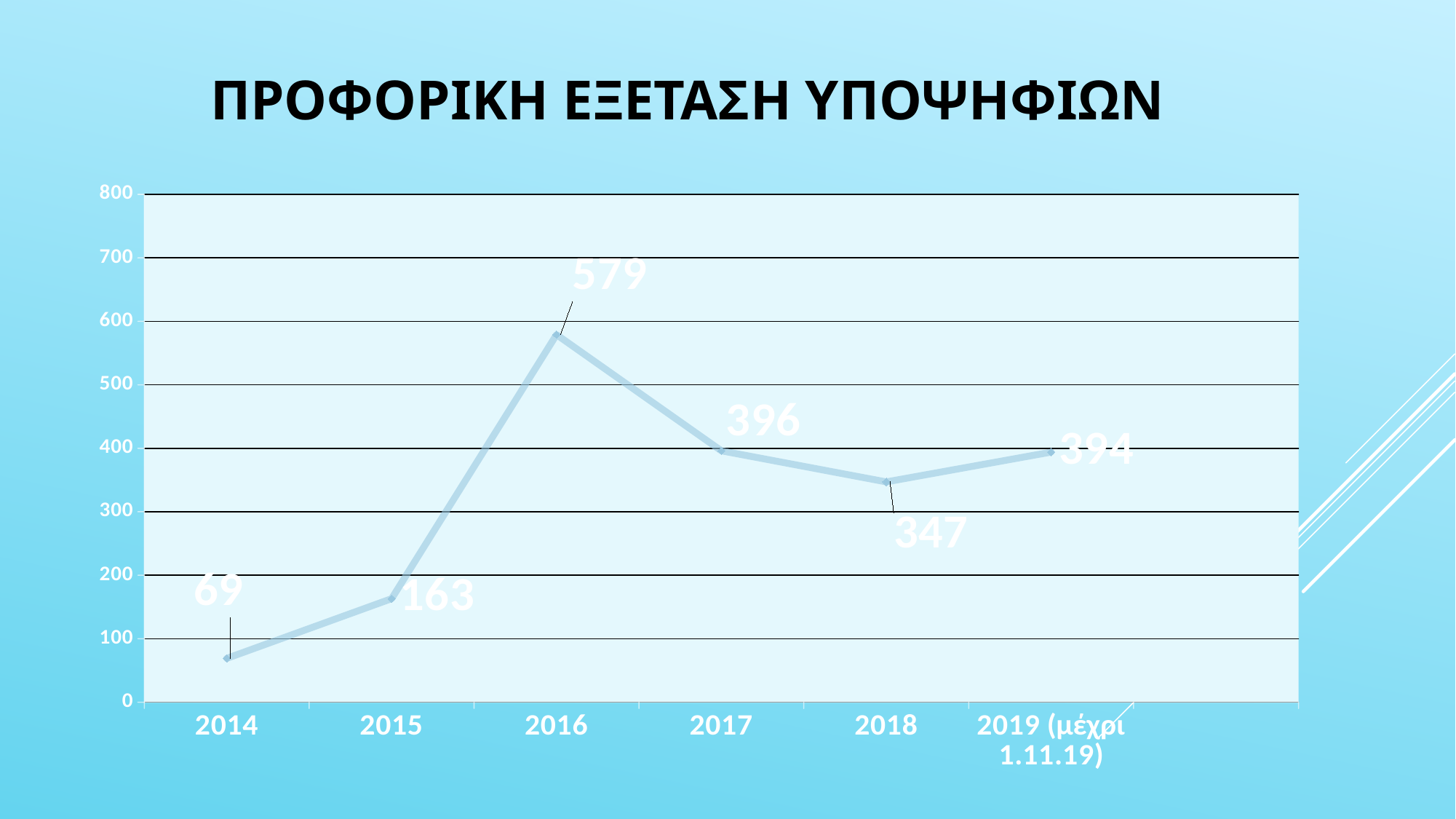
Which year has the lowest value? 2014 What is the difference between the values for 2016 and 2017? 183 Which year has the highest value? 2016 What is the value for 2016? 579 How many years are plotted on the chart? 6 What is the value for 2019 (μέχρι 1.11.19)? 394 What kind of chart is shown on the slide? line chart Which is larger, the value for 2017 or the value for 2018? 2017 What is the difference between the values for 2015 and 2014? 94 Does the value rise or fall from 2014 to 2016? rise What is the value for 2014? 69 What is the value for 2018? 347